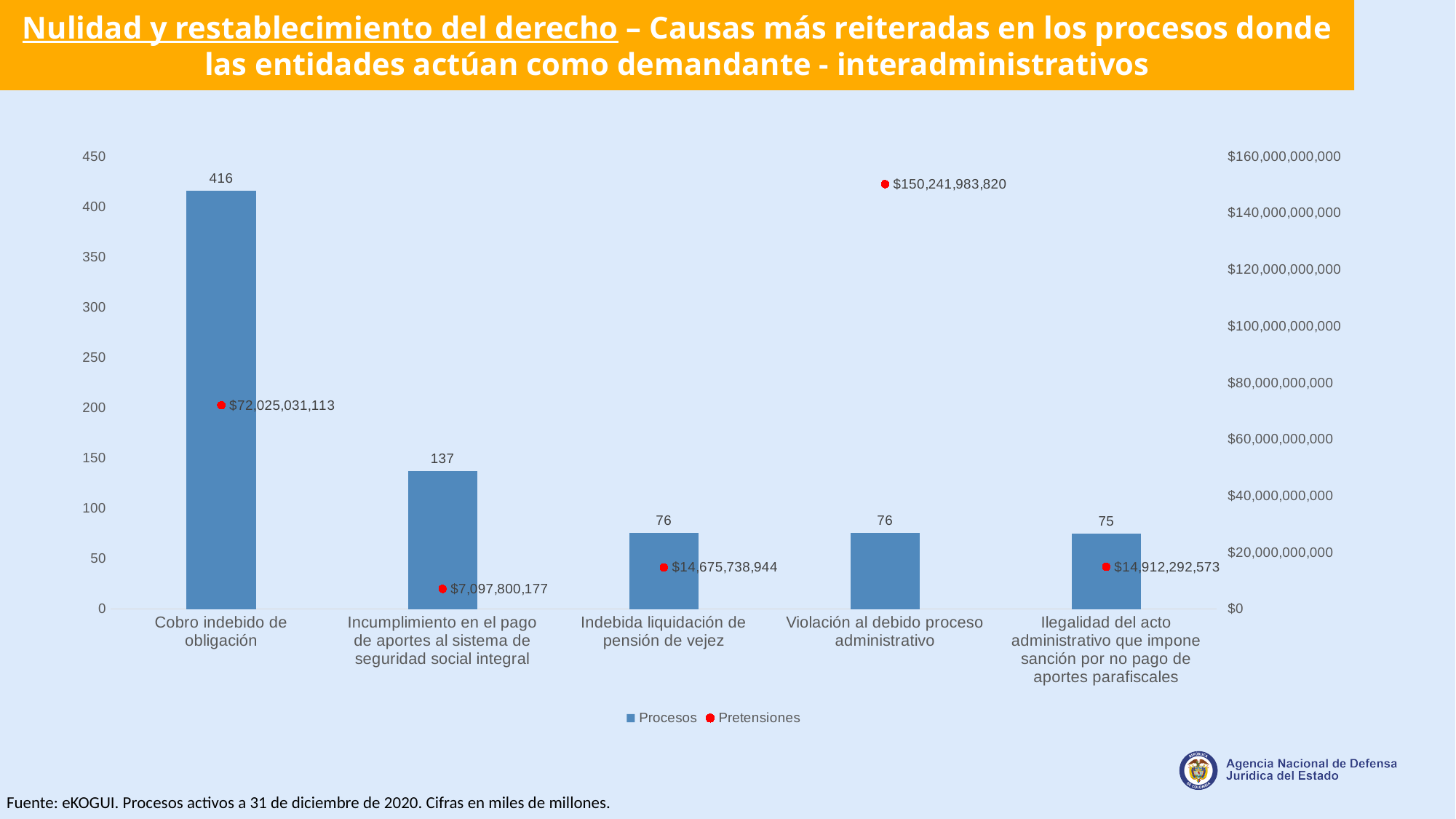
What is the Pretensiones value for 'Violación al debido proceso administrativo'? $150,241,983,820 Which category has the highest number of Procesos? Cobro indebido de obligación Which category has the highest Pretensiones value? Violación al debido proceso administrativo What is the difference in Procesos between 'Cobro indebido de obligación' and 'Incumplimiento en el pago de aportes al sistema de seguridad social integral'? 279 How many Procesos are shown for 'Cobro indebido de obligación'? 416 How many series does the chart legend list? 2 Which has the larger Pretensiones value: 'Indebida liquidación de pensión de vejez' or 'Ilegalidad del acto administrativo que impone sanción por no pago de aportes parafiscales'? Ilegalidad del acto administrativo que impone sanción por no pago de aportes parafiscales How many categories are shown on the x axis of the chart? 5 Which category has the lowest Pretensiones value? Incumplimiento en el pago de aportes al sistema de seguridad social integral How many Procesos are shown for 'Ilegalidad del acto administrativo que impone sanción por no pago de aportes parafiscales'? 75 What is the difference in Pretensiones between 'Violación al debido proceso administrativo' and 'Cobro indebido de obligación'? $78,216,952,707 What is the Pretensiones value for 'Incumplimiento en el pago de aportes al sistema de seguridad social integral'? $7,097,800,177